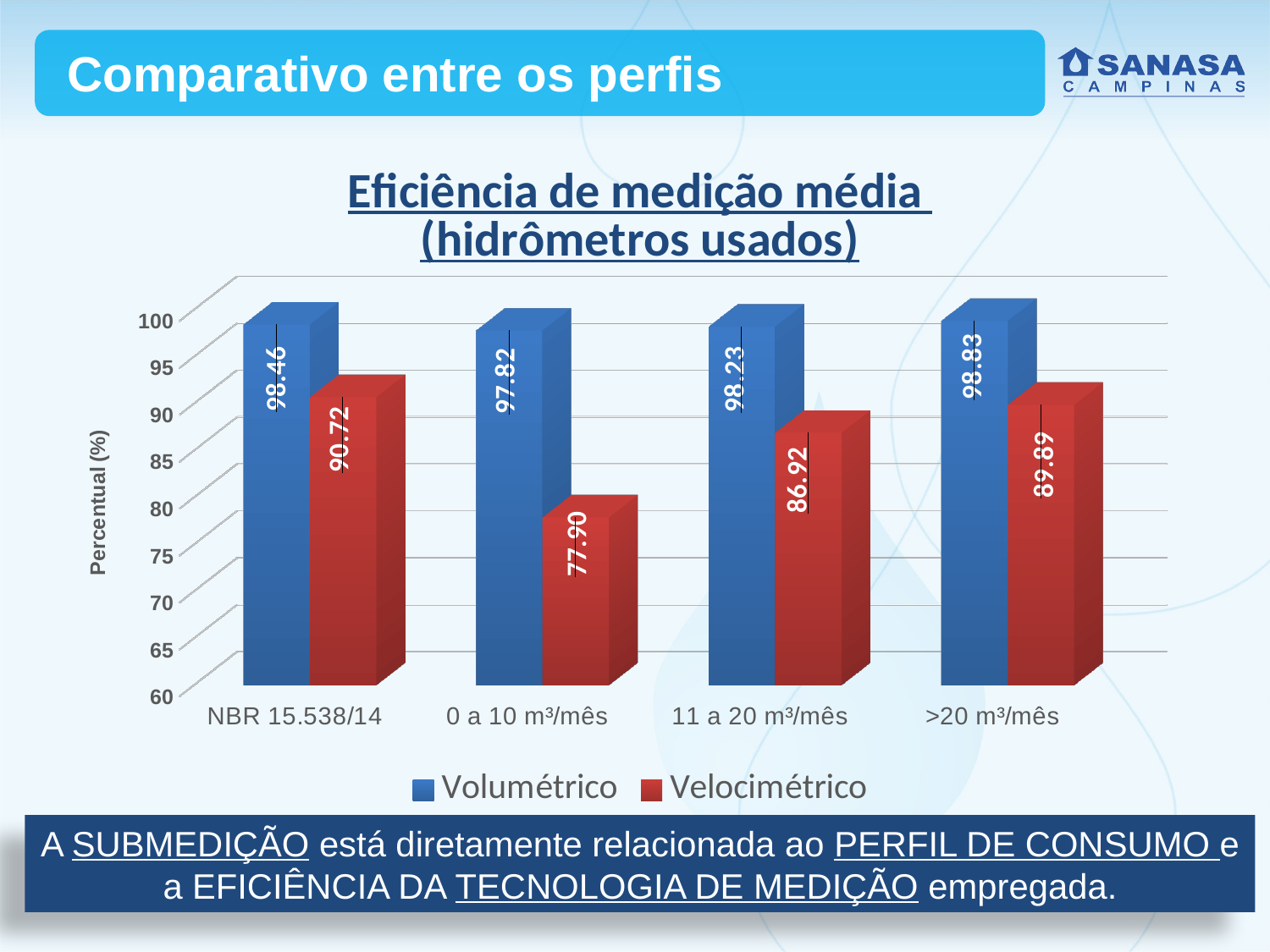
Which category has the highest Volumétrico value? >20 m³/mês What is the Volumétrico value for >20 m³/mês? 98.83 How many series does the legend list? 2 What is the difference between the Volumétrico and Velocimétrico values for 0 a 10 m³/mês? 19.92 What is the Velocimétrico value for 11 a 20 m³/mês? 86.92 Which is larger for >20 m³/mês, the Volumétrico or the Velocimétrico value? Volumétrico What kind of chart is shown on the slide? Bar chart Which category has the lowest Velocimétrico value? 0 a 10 m³/mês What is the Volumétrico value for NBR 15.538/14? 98.46 What is the title of the chart? Eficiência de medição média (hidrômetros usados) How many categories are shown on the x axis? 4 What is the Velocimétrico value for 0 a 10 m³/mês? 77.90